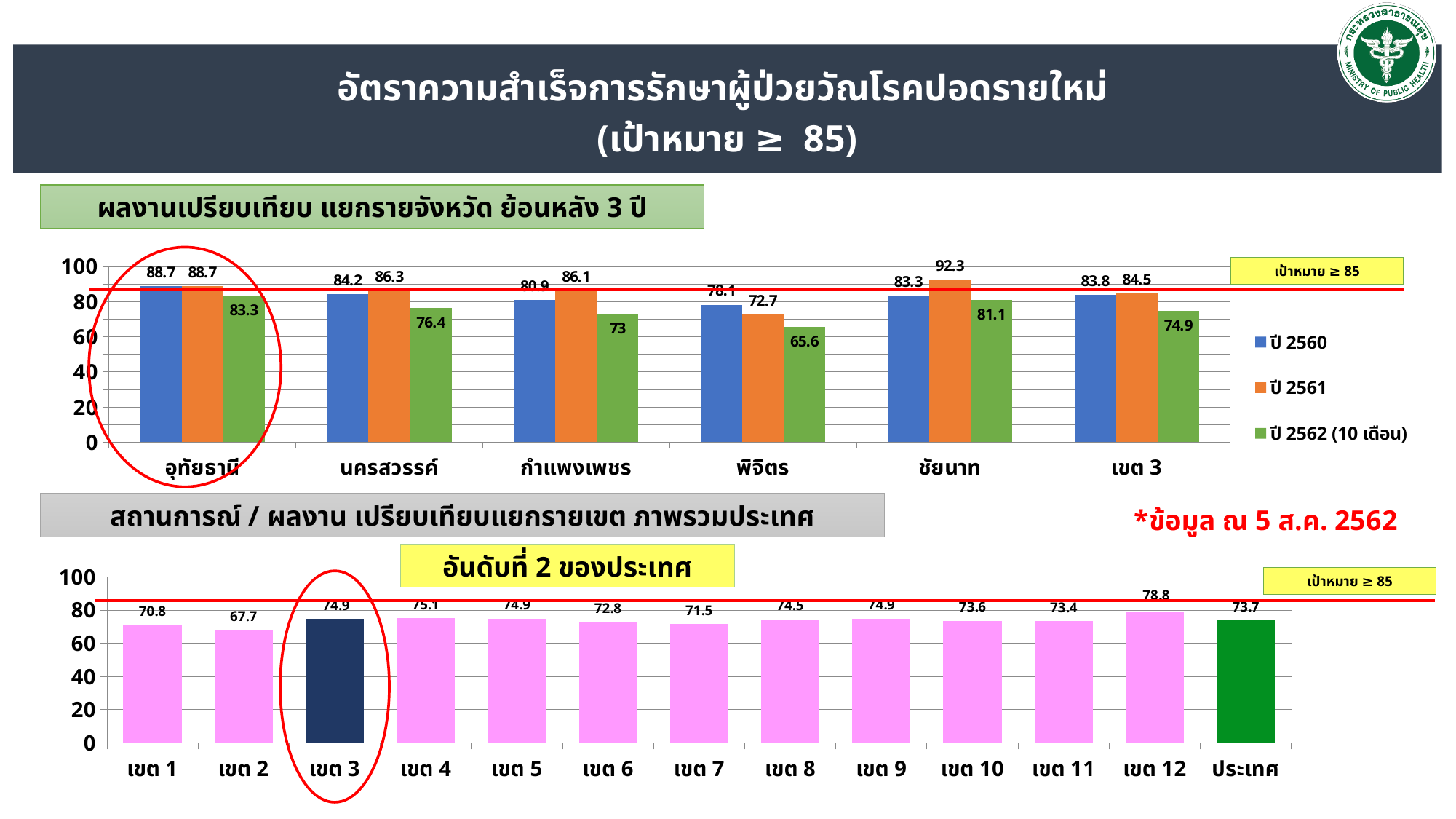
How many bars are shown in the bottom chart? 13 In the bottom chart, what is the value for เขต 12? 78.8 What type of chart is the bottom chart? bar chart In the top chart, what is the value for ชัยนาท in the ปี 2561 series? 92.3 In the top chart, is the ปี 2560 value for นครสวรรค์ larger or smaller than its ปี 2561 value? smaller In the bottom chart, which category has the highest value? เขต 12 How many series does the legend of the top chart list? 3 In the top chart, what is the difference between the ปี 2561 and ปี 2562 (10 เดือน) values for กำแพงเพชร? 13.1 In the top chart, what is the value for พิจิตร in the ปี 2562 (10 เดือน) series? 65.6 In the top chart, which province has the highest value in the ปี 2561 series? ชัยนาท In the top chart, which category has the lowest value in the ปี 2562 (10 เดือน) series? พิจิตร In the bottom chart, which category has the lowest value? เขต 2